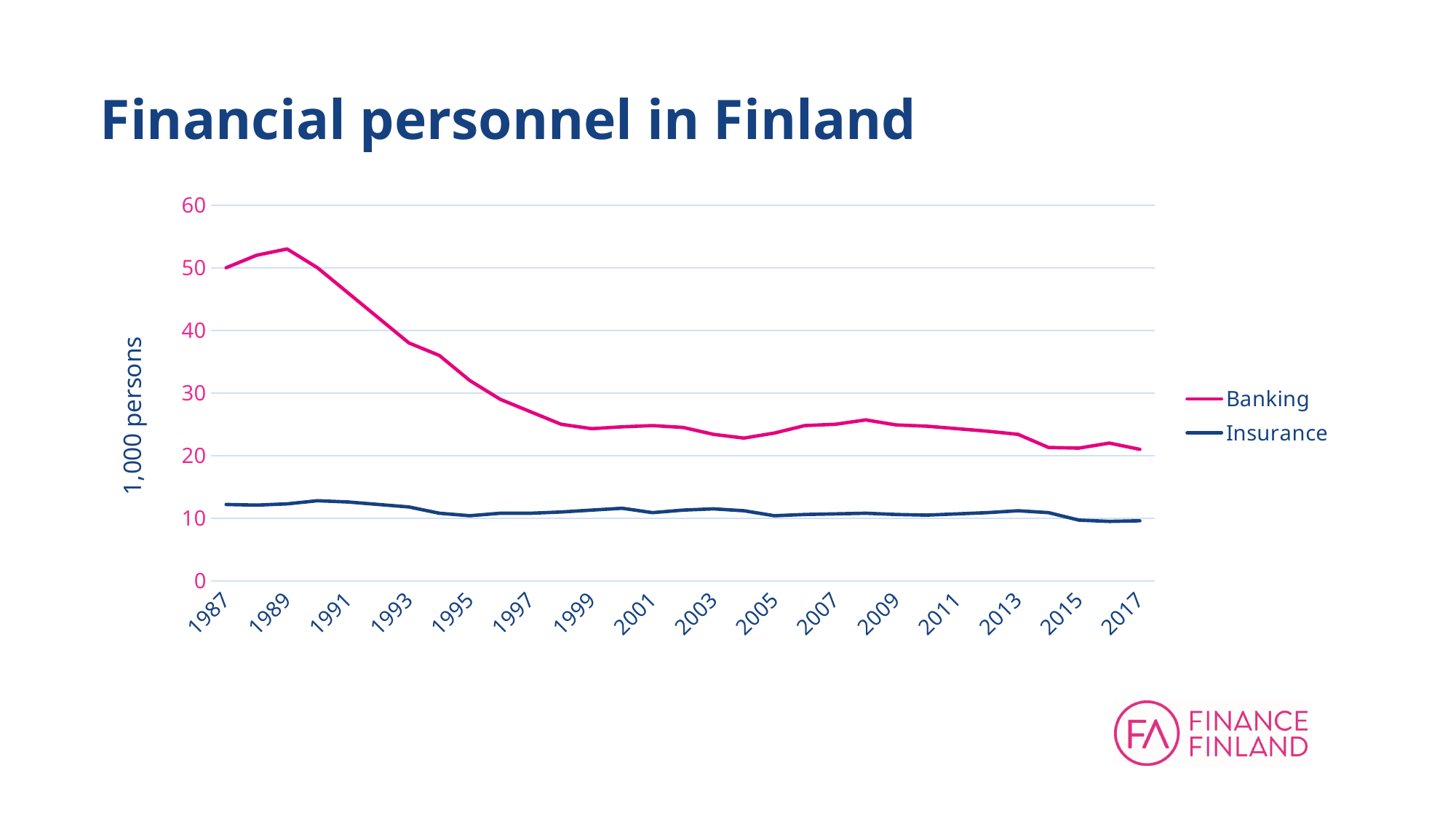
Is the value for Banking in 1991 greater or less than 40? greater Is the value for Insurance in 1989 greater or less than 10? greater Does the Banking line rise or fall overall from 1987 to 2017? fall Is the value for Banking in 2017 greater or less than 30? less What are the two series named in the legend? Banking and Insurance What is the label on the vertical axis? 1,000 persons How many year labels are shown on the horizontal axis? 16 In which year does the Banking series reach its highest value? 1989 What kind of chart is shown on the slide? line chart How many series does the legend list? 2 Which series has the larger value in 2017, Banking or Insurance? Banking